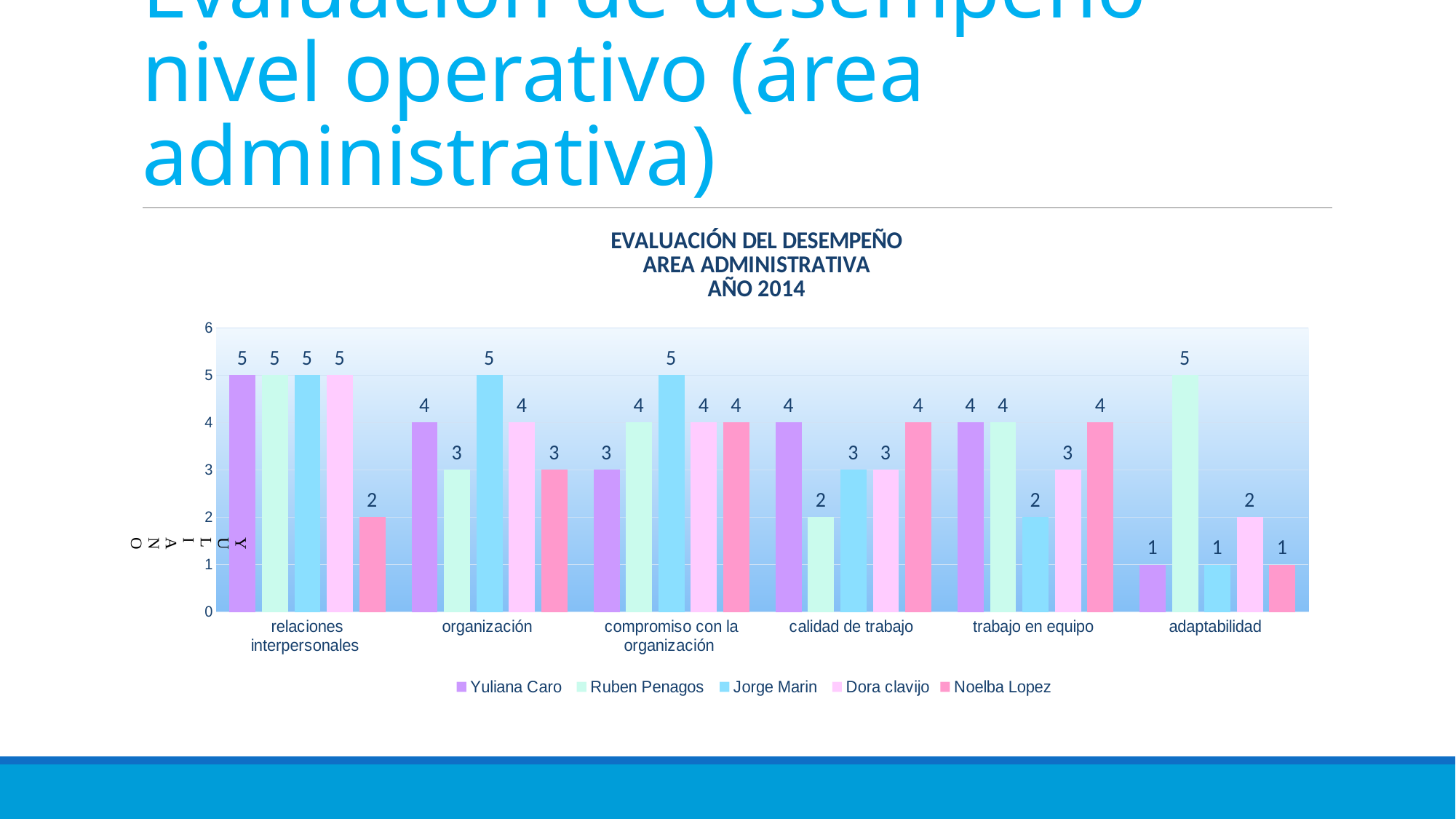
What kind of chart is shown on the slide? Bar chart What value does Noelba Lopez have for relaciones interpersonales? 2 Which person has the highest value for adaptabilidad? Ruben Penagos What value does Jorge Marin have for organización? 5 How many categories are shown on the x axis? 6 Which person has the lowest value for calidad de trabajo? Ruben Penagos What is the title of the chart? EVALUACIÓN DEL DESEMPEÑO AREA ADMINISTRATIVA AÑO 2014 What value does Yuliana Caro have for compromiso con la organización? 3 What value does Ruben Penagos have for adaptabilidad? 5 How many series does the legend list? 5 For trabajo en equipo, who has the larger value, Jorge Marin or Dora clavijo? Dora clavijo What is the difference between Jorge Marin's and Ruben Penagos's values for organización? 2